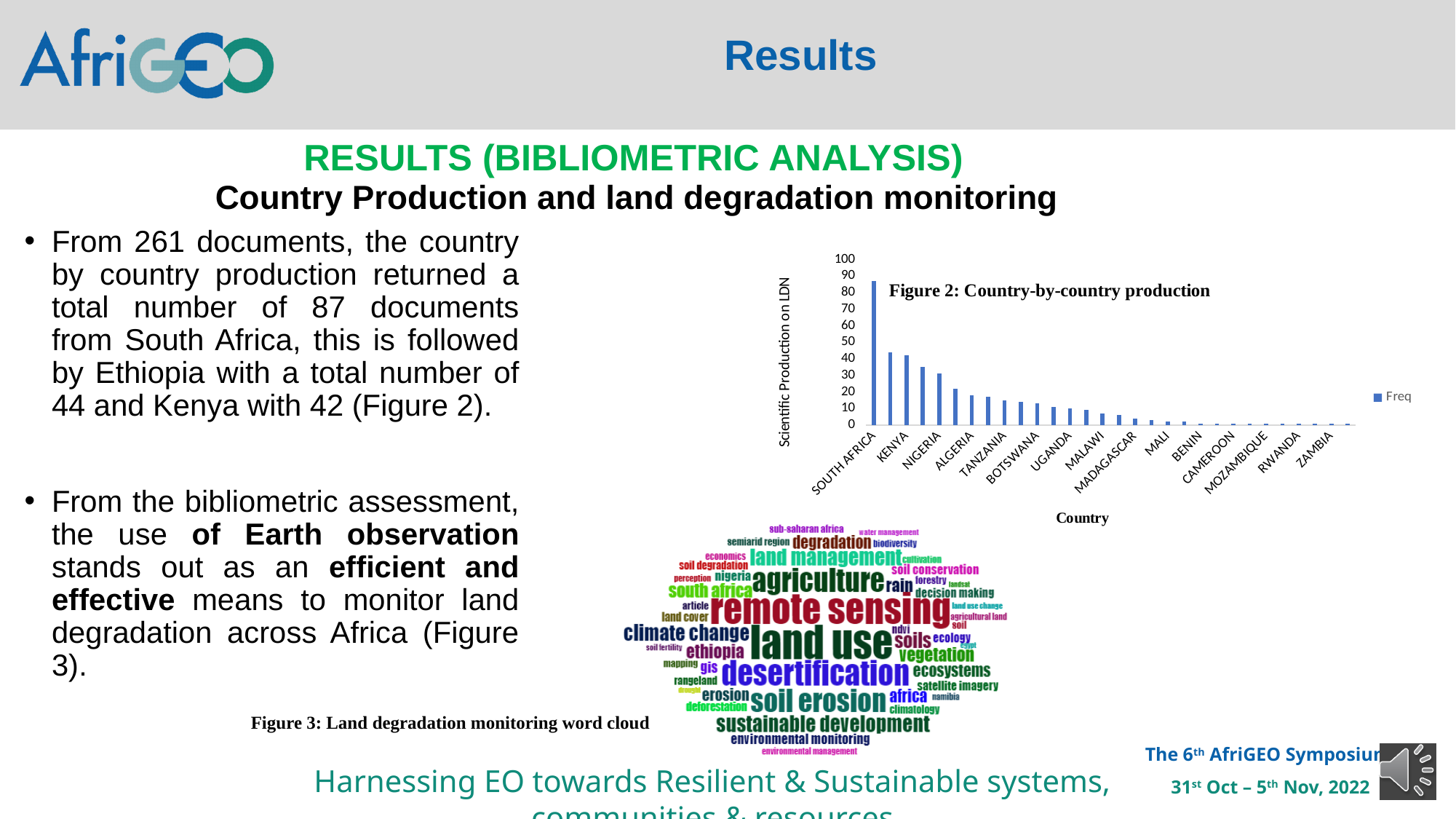
How many series does the legend of Figure 2: Country-by-country production list? 1 In Figure 2: Country-by-country production, what is the difference between the number of documents from South Africa and from Ethiopia? 43 In Figure 2: Country-by-country production, do the values rise or fall from left to right along the x axis? fall In Figure 2: Country-by-country production, is the value for Nigeria greater or less than 50? less In Figure 2: Country-by-country production, is the value for Algeria greater or less than 30? less In Figure 2: Country-by-country production, which has a higher value, Kenya or Nigeria? Kenya What is the y-axis title of Figure 2: Country-by-country production? Scientific Production on LDN In Figure 2: Country-by-country production, which country has the highest scientific production? South Africa What kind of chart is Figure 2: Country-by-country production? bar chart In Figure 2: Country-by-country production, how many documents are attributed to Kenya? 42 In Figure 2: Country-by-country production, how many documents are attributed to South Africa? 87 In Figure 2: Country-by-country production, is the value for South Africa greater or less than 80? greater